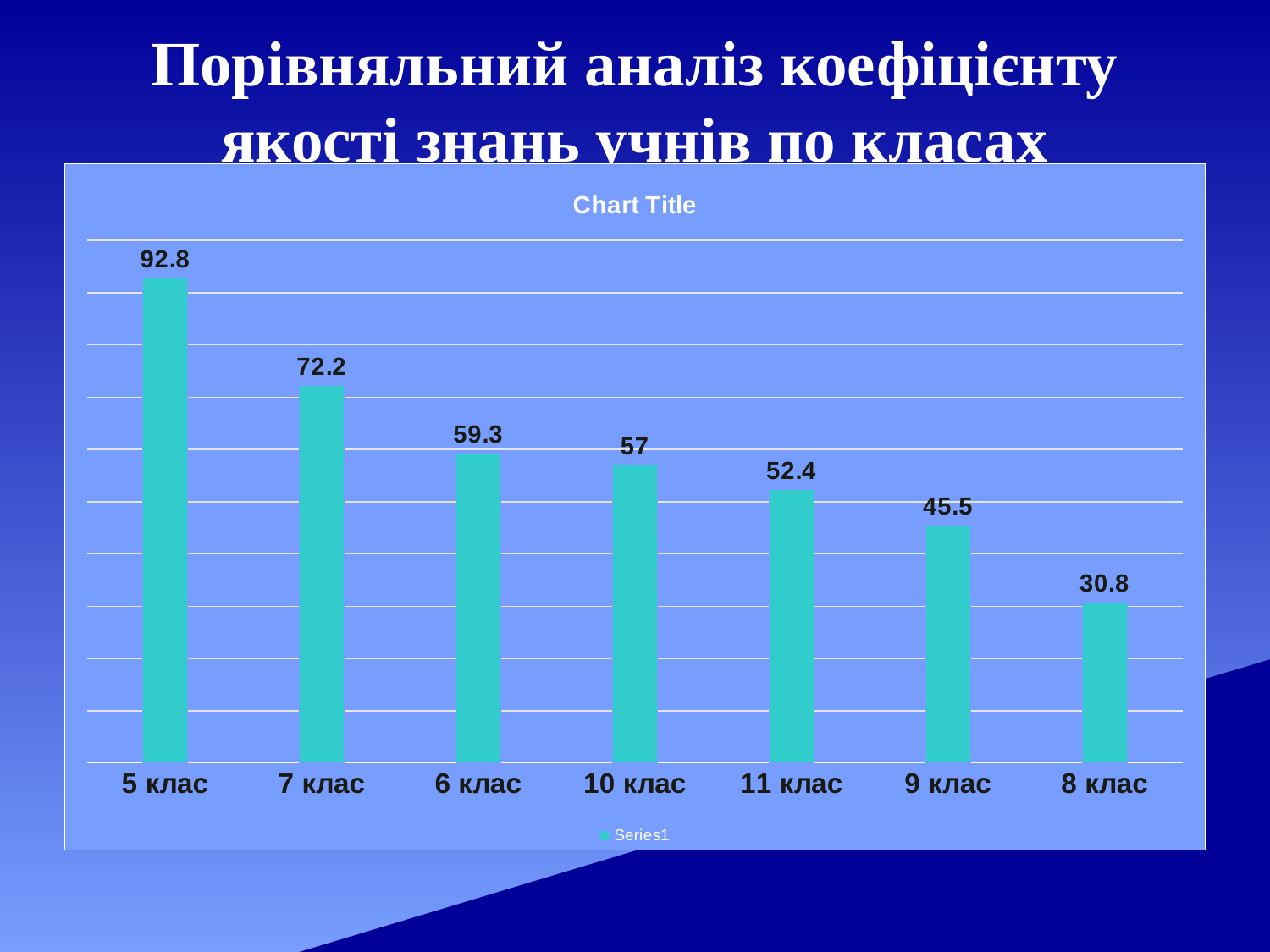
Do the values rise or fall from left to right along the x axis? fall What is the difference between the values for 7 клас and 6 клас? 12.9 Which class has the highest value? 5 клас What kind of chart is shown on the slide? bar chart What is the value for 10 клас? 57 What is the value for 5 клас? 92.8 What is the difference between the values for 5 клас and 8 клас? 62 Which class has the lowest value? 8 клас Which is larger, the value for 11 клас or the value for 9 клас? 11 клас How many classes are shown on the chart? 7 What is the value for 9 клас? 45.5 How many series does the legend list? 1